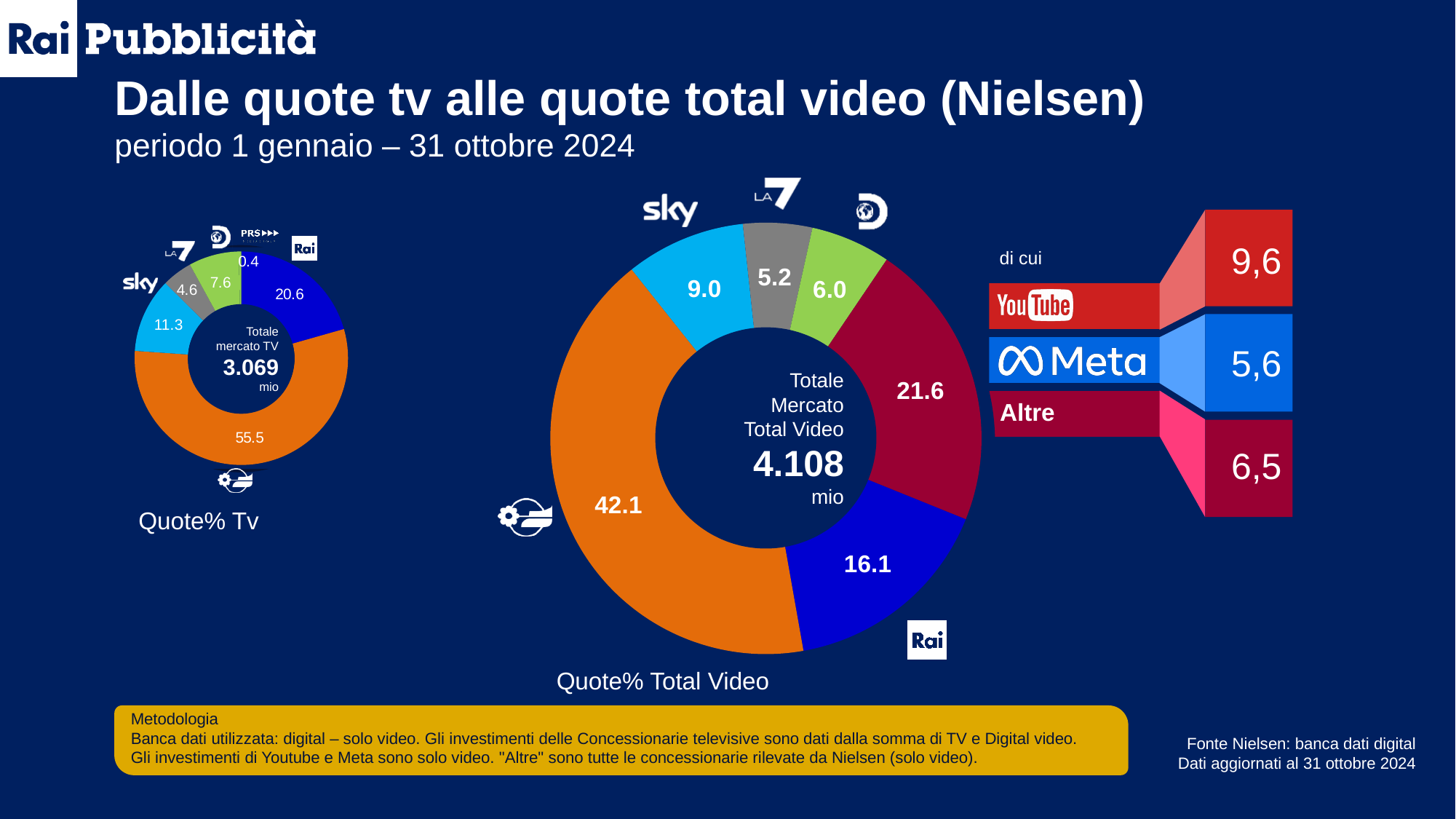
In the Quote% Tv chart, what is the value for La7? 4.6 In the Quote% Total Video chart, what is the difference between the Rai value and the Sky value? 7.1 In the Quote% Total Video chart, which has the larger value, Sky or La7? Sky In the Quote% Tv chart, what is the value for Rai? 20.6 In the Quote% Total Video chart, what is the value for La7? 5.2 In the Quote% Total Video chart, what is the value for Sky? 9.0 In the Quote% Tv chart, what is the largest value shown on any slice? 55.5 In the Quote% Tv chart, what is the value for Sky? 11.3 In the Quote% Total Video chart, what is the value for Rai? 16.1 In the Quote% Total Video chart, what is the value shown for YouTube in the breakdown of the 21.6 slice? 9,6 In the Quote% Tv chart, what is the total shown in the centre (Totale mercato TV)? 3.069 mio What kind of chart is the Quote% Total Video chart? Donut (pie) chart